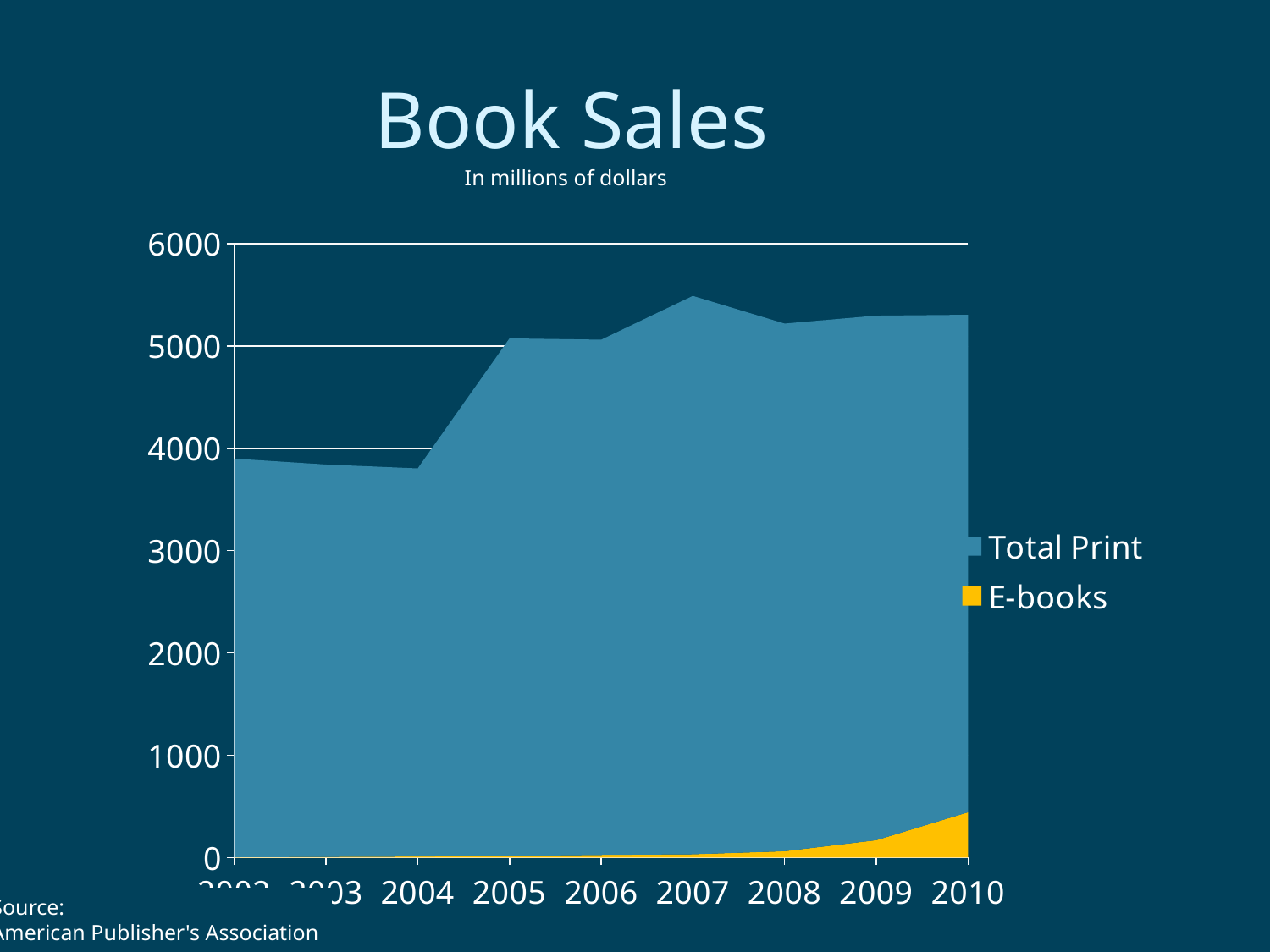
In what units are the values on the chart expressed, according to the subtitle? In millions of dollars Which is larger, the Total Print value in 2007 or in 2004? 2007 Is the value for Total Print in 2007 greater or less than 5000? greater How many series does the legend list? 2 Do the E-books values rise or fall from 2004 to 2010? rise Which is larger, the E-books value in 2010 or in 2008? 2010 Is the value for Total Print in 2008 greater or less than 5000? greater What kind of chart is shown on the slide? Area chart In which year is the Total Print value highest? 2007 Is the value for E-books in 2010 greater or less than 1000? less What is the title of the chart? Book Sales